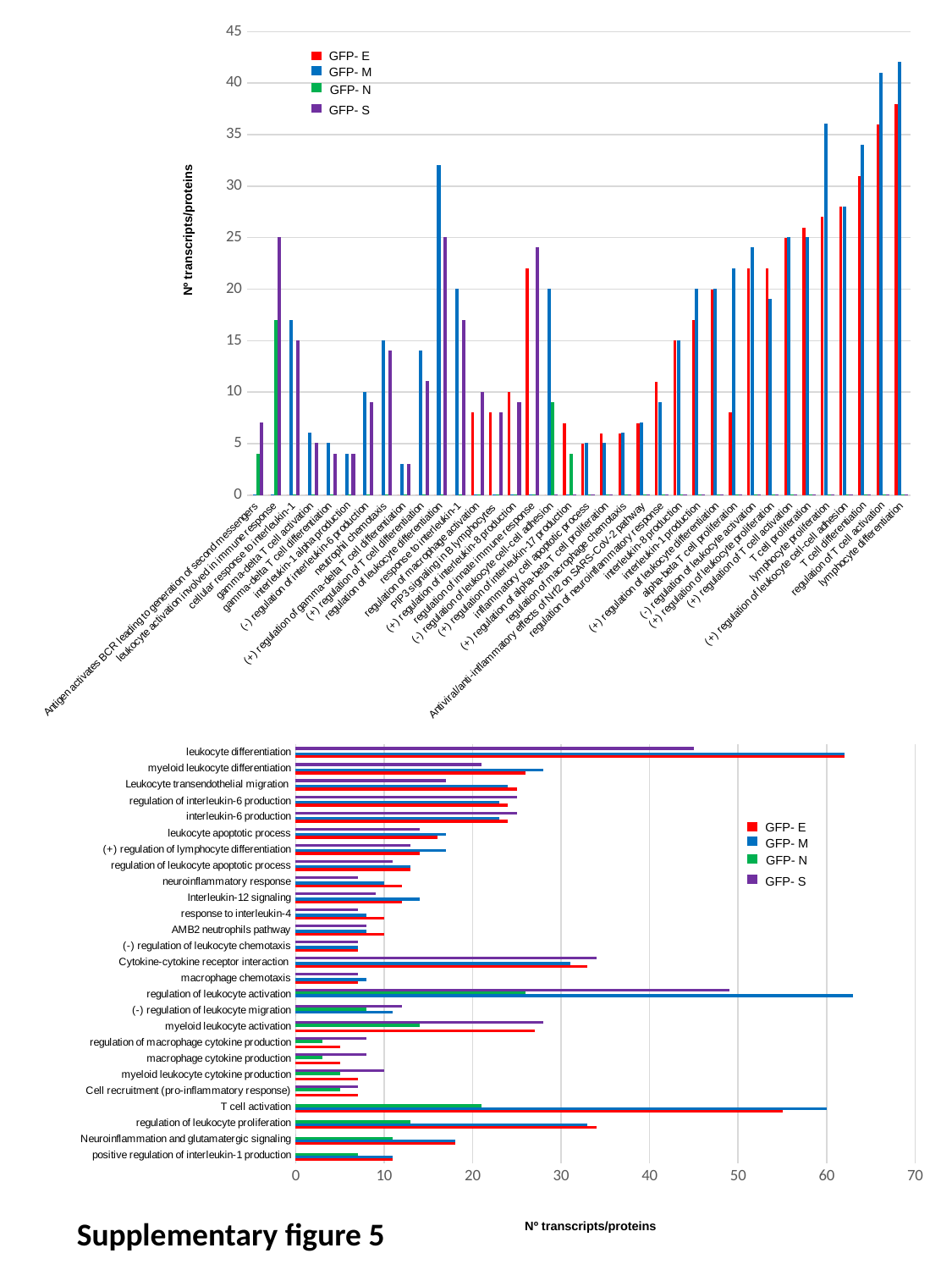
What is the title of the vertical axis of the top chart? Nº transcripts/proteins In the top chart, is the GFP- S value for leukocyte activation involved in immune response greater or less than 20? greater In the top chart, is the GFP- M value for lymphocyte differentiation greater or less than 40? greater What kind of chart is the bottom chart on the slide? bar chart In the bottom chart, how many categories are plotted on the vertical axis? 26 In the bottom chart, is the GFP- E value for T cell activation greater or less than 50? greater In the bottom chart, for leukocyte differentiation, which series has the larger value, GFP- E or GFP- S? GFP- E In the bottom chart, for regulation of leukocyte activation, which series has the larger value, GFP- M or GFP- S? GFP- M In the top chart, how many series does the legend list? 4 What kind of chart is the top chart on the slide? bar chart